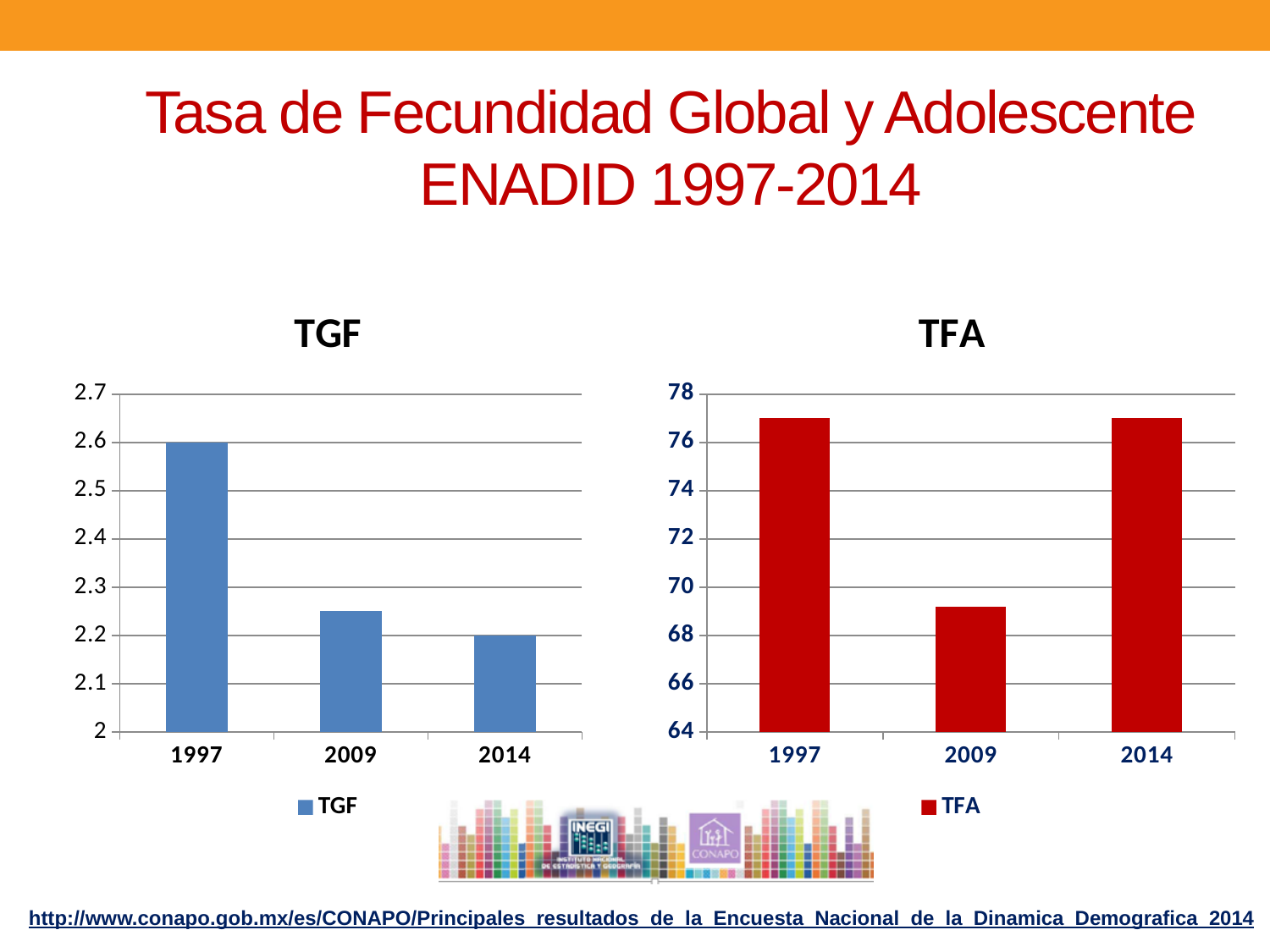
In the TGF chart, what is the value for 2014? 2.2 In the TFA chart, which year has the lowest value? 2009 In the TGF chart, what is the value for 1997? 2.6 What kind of chart is the TGF chart on the left? bar chart How many series does the legend of the TFA chart list? 1 In the TGF chart, how many years are shown on the x axis? 3 In the TFA chart, which is larger, the value for 2009 or the value for 2014? 2014 In the TGF chart, which year has the lowest value? 2014 In the TGF chart, which year has the highest value? 1997 In the TFA chart, is the value for 2009 greater or less than 70? less In the TGF chart, do the values rise or fall from 1997 to 2014? fall In the TFA chart, is the value for 1997 greater or less than 76? greater